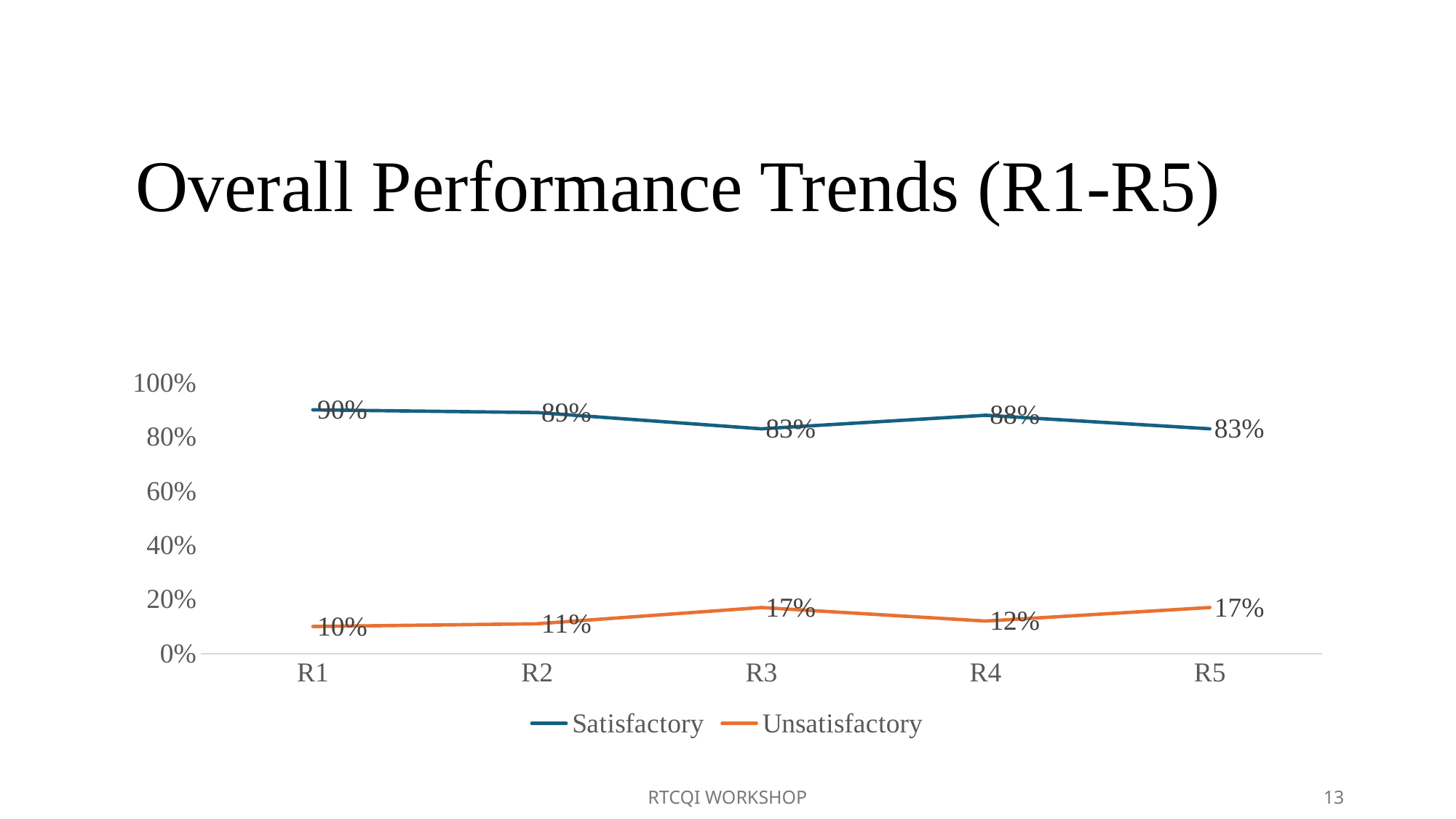
At which round is the Unsatisfactory value lowest? R1 What is the difference between the Satisfactory values at R1 and R5? 7% Which is larger, the Unsatisfactory value at R2 or at R4? R4 What is the Unsatisfactory value at R3? 17% Is the Satisfactory value at R3 greater or less than 60%? greater How many series does the legend list? 2 How many rounds are shown on the x axis? 5 What is the Satisfactory value at R4? 88% What is the Satisfactory value at R1? 90% At which round is the Satisfactory value highest? R1 What is the Unsatisfactory value at R5? 17% What kind of chart is shown on the slide? line chart